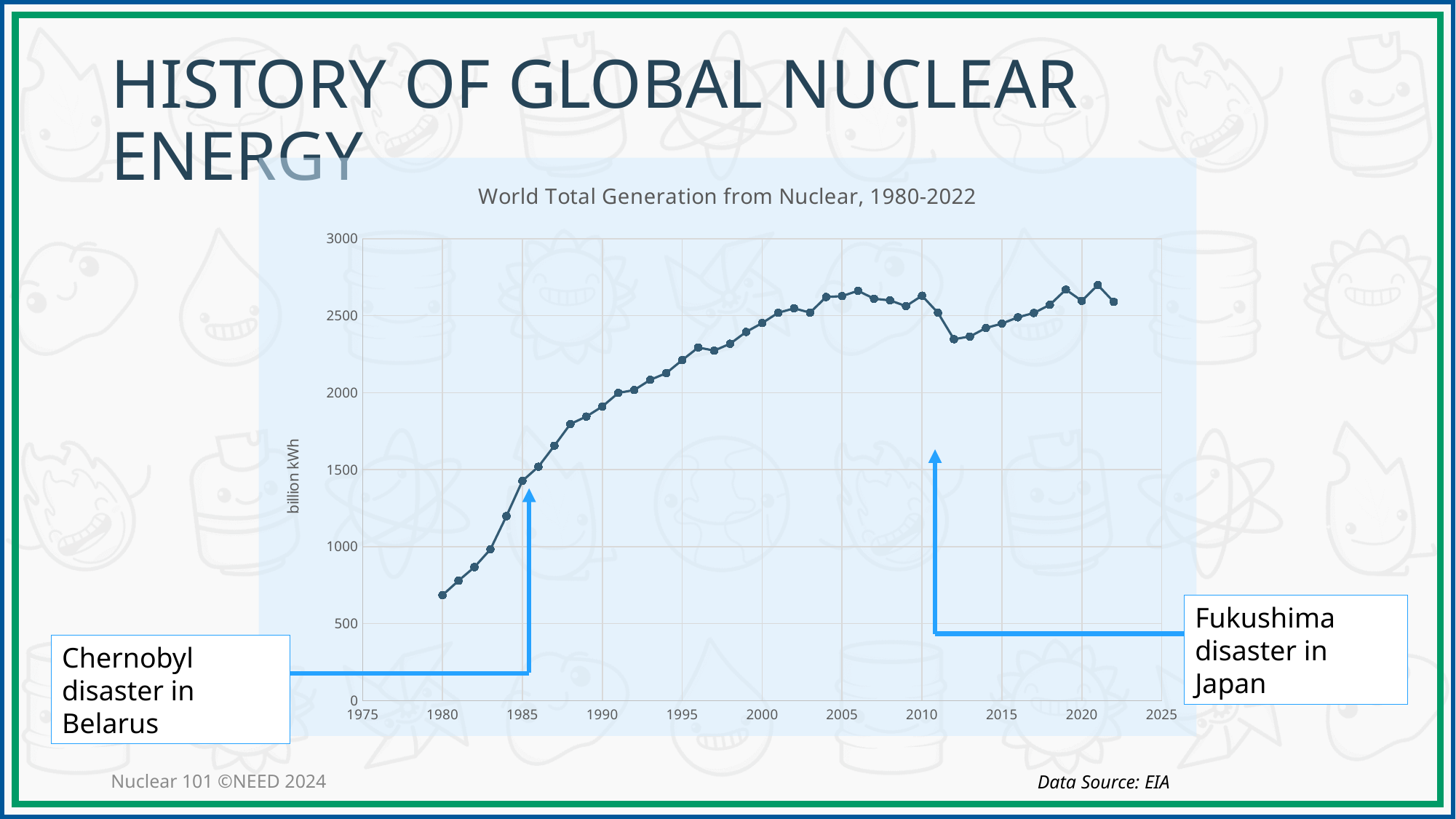
Is the value for 1980 greater or less than 1000? less What unit is shown on the y-axis label of the chart? billion kWh Is the value for 2006 greater or less than 2500? greater Is the value for 2012 greater or less than 2500? less Does world nuclear generation rise or fall between 1980 and 2005? rise What type of chart is shown on the slide? line chart What is the title of the chart? World Total Generation from Nuclear, 1980-2022 Which year has the lowest value on the chart? 1980 Does world nuclear generation rise or fall between 2010 and 2012? fall